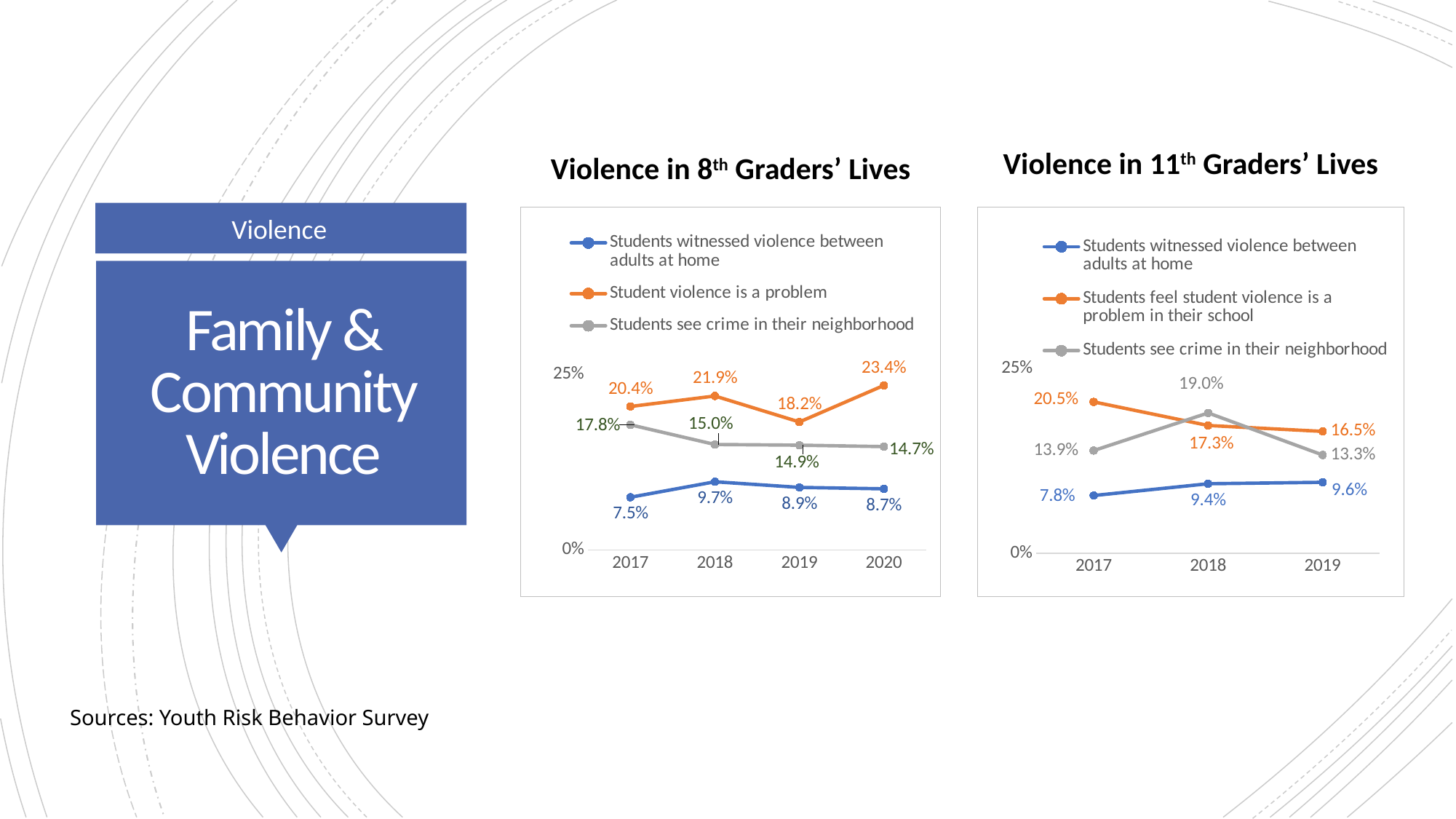
How many years are shown on the x axis of the 'Violence in 8th Graders' Lives' chart? 4 In the 'Violence in 8th Graders' Lives' chart, what percentage of students said student violence is a problem in 2020? 23.4% In the 'Violence in 8th Graders' Lives' chart, which year has the highest value for students who said student violence is a problem? 2020 How many series does the legend of the 'Violence in 11th Graders' Lives' chart list? 3 In the 'Violence in 8th Graders' Lives' chart, what is the difference between the 2020 and 2019 values for students who said student violence is a problem? 5.2% In the 'Violence in 11th Graders' Lives' chart, does the value for students who feel student violence is a problem in their school rise or fall from 2017 to 2019? Fall In the 'Violence in 11th Graders' Lives' chart, which year has the lowest value for students who witnessed violence between adults at home? 2017 In the 'Violence in 11th Graders' Lives' chart, what percentage of students felt student violence is a problem in their school in 2019? 16.5% In the 'Violence in 11th Graders' Lives' chart, which is larger in 2018: students who see crime in their neighborhood or students who feel student violence is a problem in their school? Students see crime in their neighborhood In the 'Violence in 11th Graders' Lives' chart, what percentage of students saw crime in their neighborhood in 2018? 19.0% What kind of chart is 'Violence in 11th Graders' Lives'? Line chart In the 'Violence in 8th Graders' Lives' chart, what percentage of students witnessed violence between adults at home in 2017? 7.5%